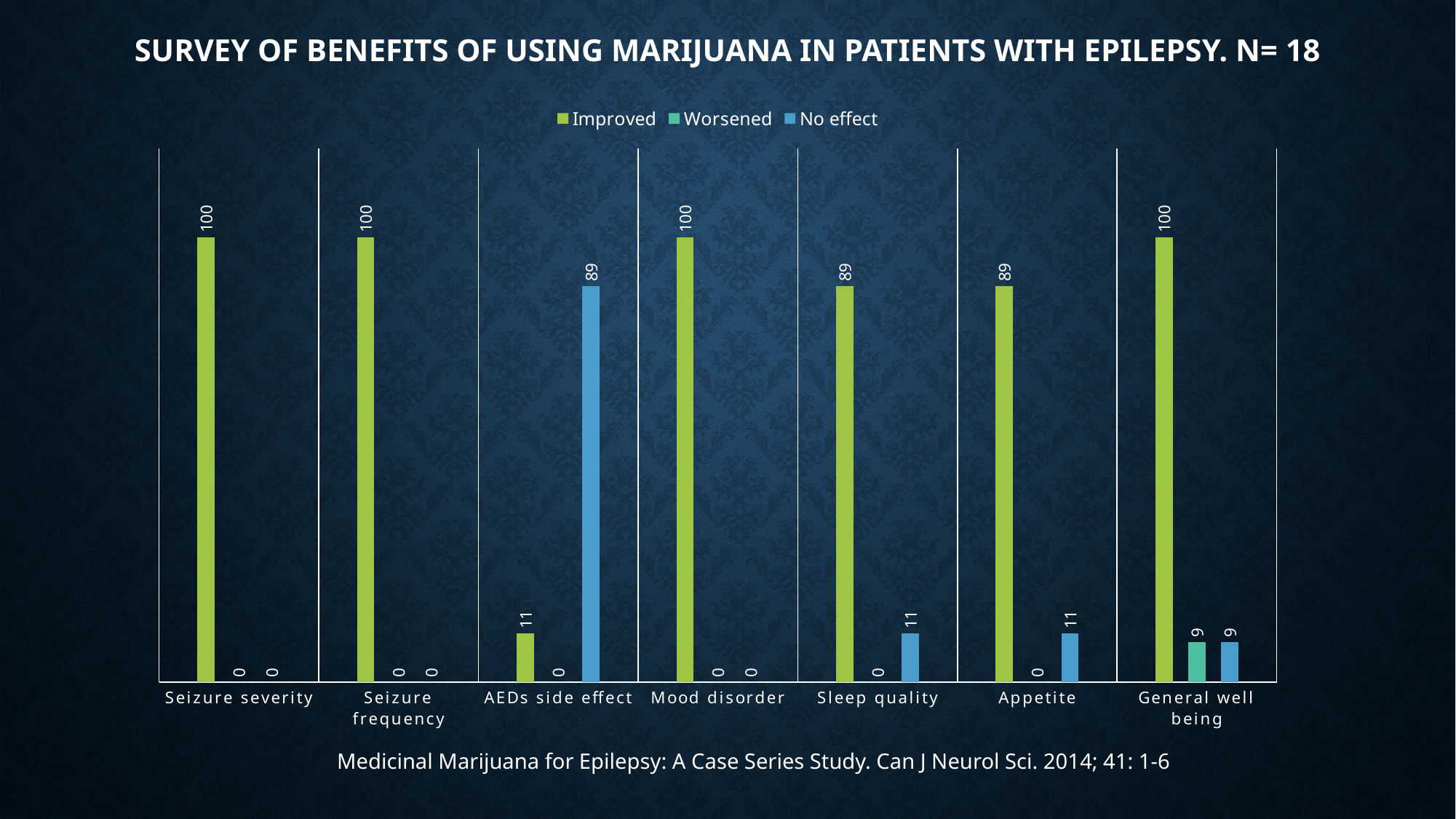
What is the No effect value for AEDs side effect? 89 What is the Improved value for Sleep quality? 89 How many series does the legend list? 3 What is the difference between the Improved and No effect values for AEDs side effect? 78 What is the Improved value for Seizure severity? 100 How many categories are shown on the x axis? 7 What is the Worsened value for General well being? 9 Which is larger for Appetite, the Improved value or the No effect value? Improved What kind of chart is shown on the slide? Bar chart Which category has the lowest Improved value? AEDs side effect Which category has the highest No effect value? AEDs side effect